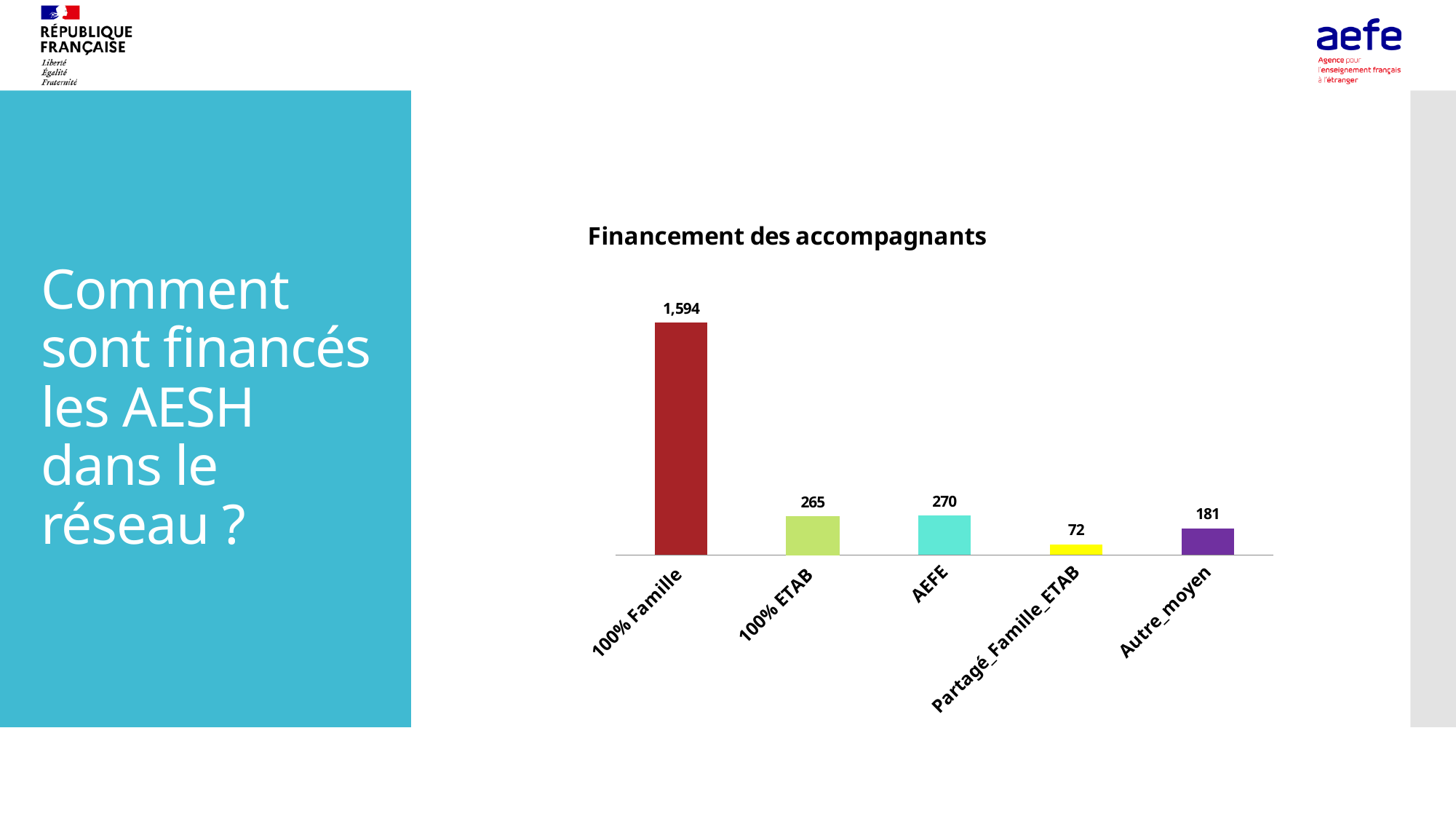
What is the title of the chart? Financement des accompagnants Which category has the lowest value? Partagé_Famille_ETAB What is the difference between the values for Autre_moyen and Partagé_Famille_ETAB? 109 What is the value for AEFE? 270 What is the value for Partagé_Famille_ETAB? 72 What is the value for 100% ETAB? 265 What is the value for Autre_moyen? 181 Which is larger, the value for 100% ETAB or the value for Autre_moyen? 100% ETAB Which category has the highest value? 100% Famille How many categories are shown in the chart? 5 What is the value for 100% Famille? 1,594 What is the difference between the values for 100% Famille and AEFE? 1,324